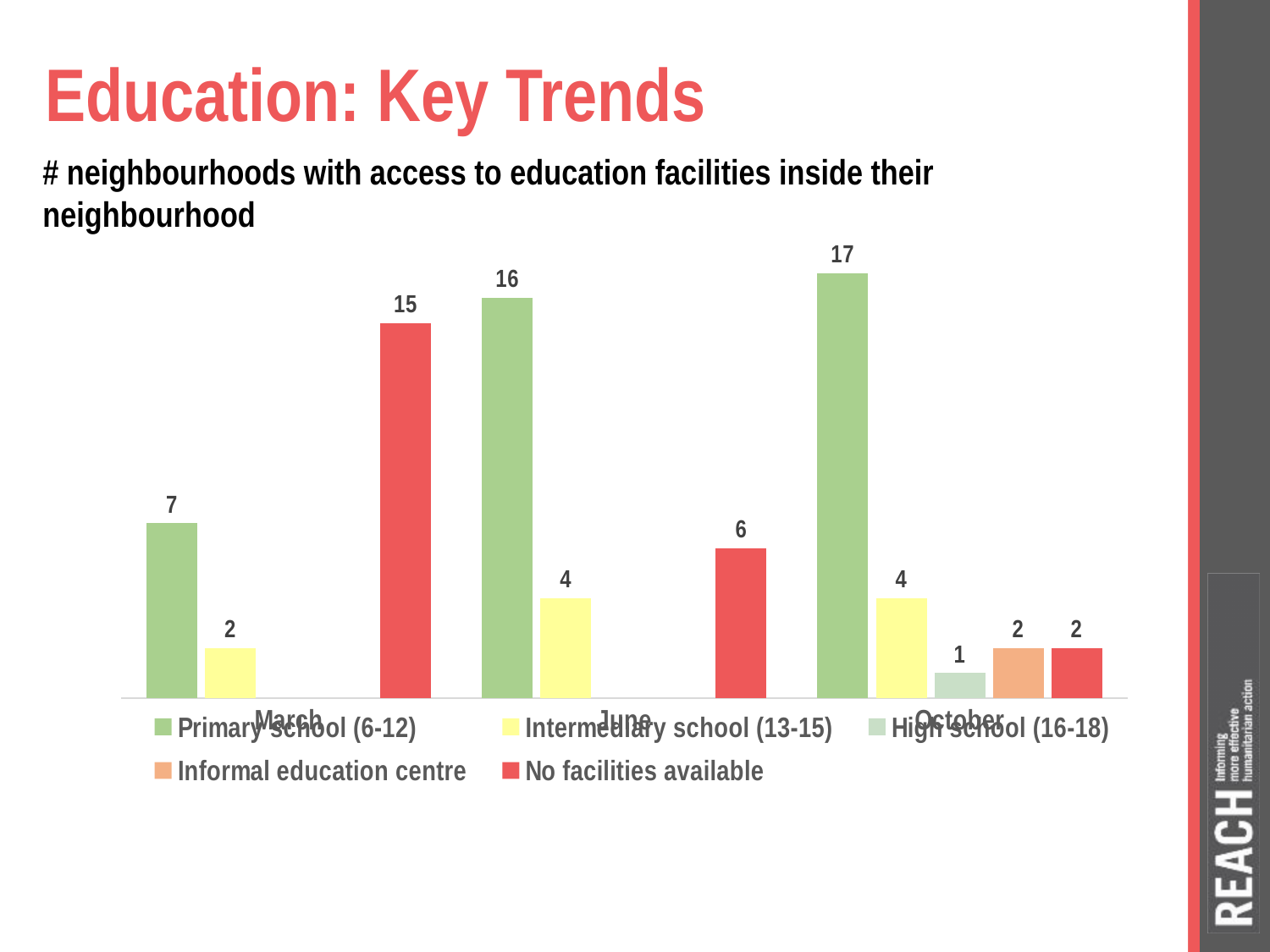
How many months are shown on the x axis? 3 What is the value for Primary school (6-12) in March? 7 In which month is the No facilities available value lowest? October What is the value for No facilities available in June? 6 Does the Primary school (6-12) value rise or fall from March to October? Rise Which is larger in March: Primary school (6-12) or No facilities available? No facilities available What kind of chart is shown on the slide? Bar chart What is the difference between the No facilities available values in March and October? 13 How many series does the legend list? 5 What is the value for Informal education centre in October? 2 In which month is the Primary school (6-12) value highest? October What is the value for High school (16-18) in October? 1